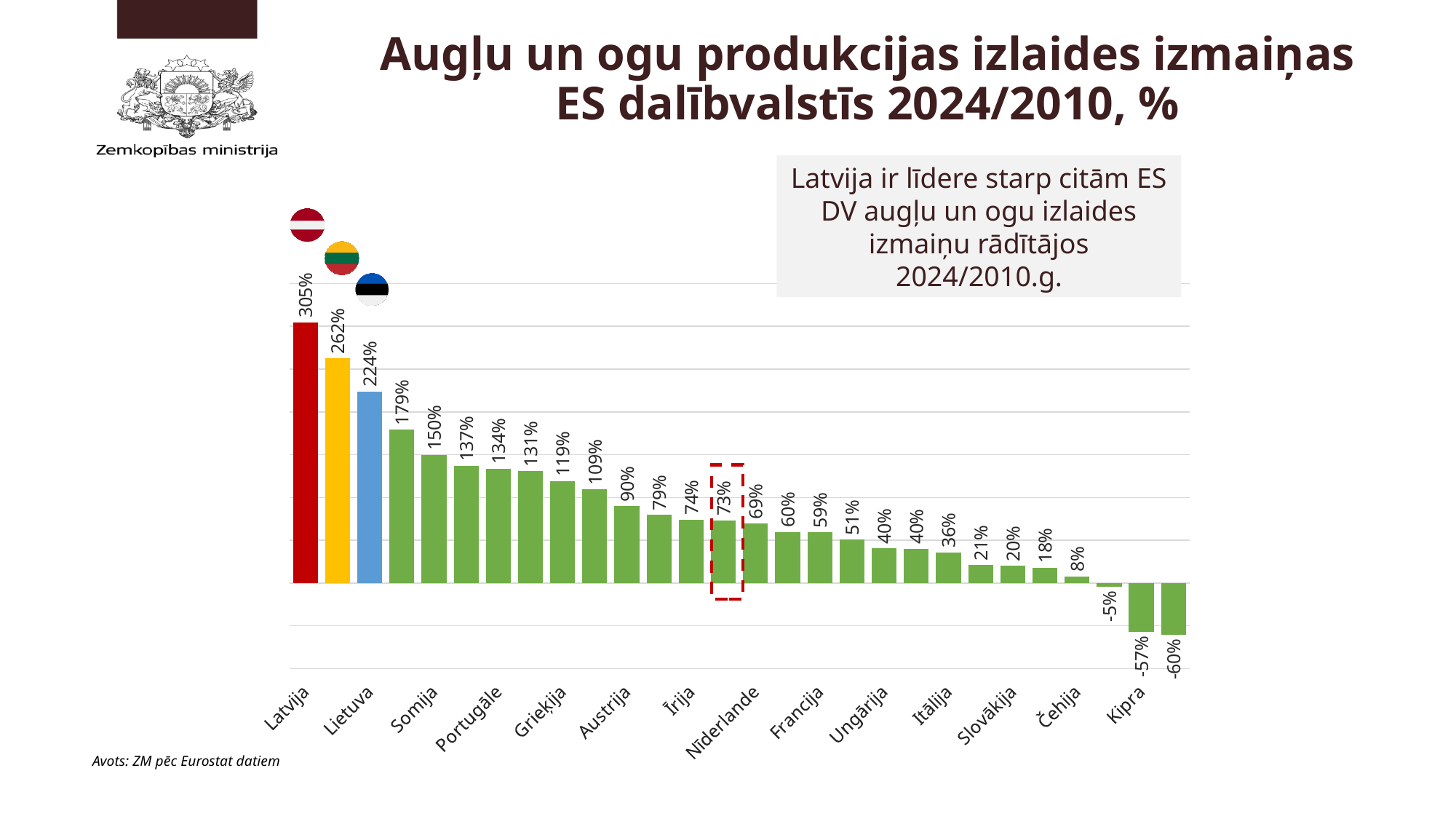
What is the difference between the highest value (305%) and the second highest value (262%)? 43 percentage points What is the value of the second highest bar in the chart? 262% What is the lowest value shown in the chart? -60% Do the values rise or fall from left to right along the x axis? Fall What kind of chart is shown on the slide? Bar chart Which country has the highest value in the chart? Latvija How many bars are plotted in the chart? 28 Is the value for Latvija greater or less than 300%? greater How many bars in the chart have negative values? 3 What is the title of the chart on the slide? Augļu un ogu produkcijas izlaides izmaiņas ES dalībvalstīs 2024/2010, % Which value is highlighted with a red dashed box in the chart? 73% What is the value shown for Latvija? 305%